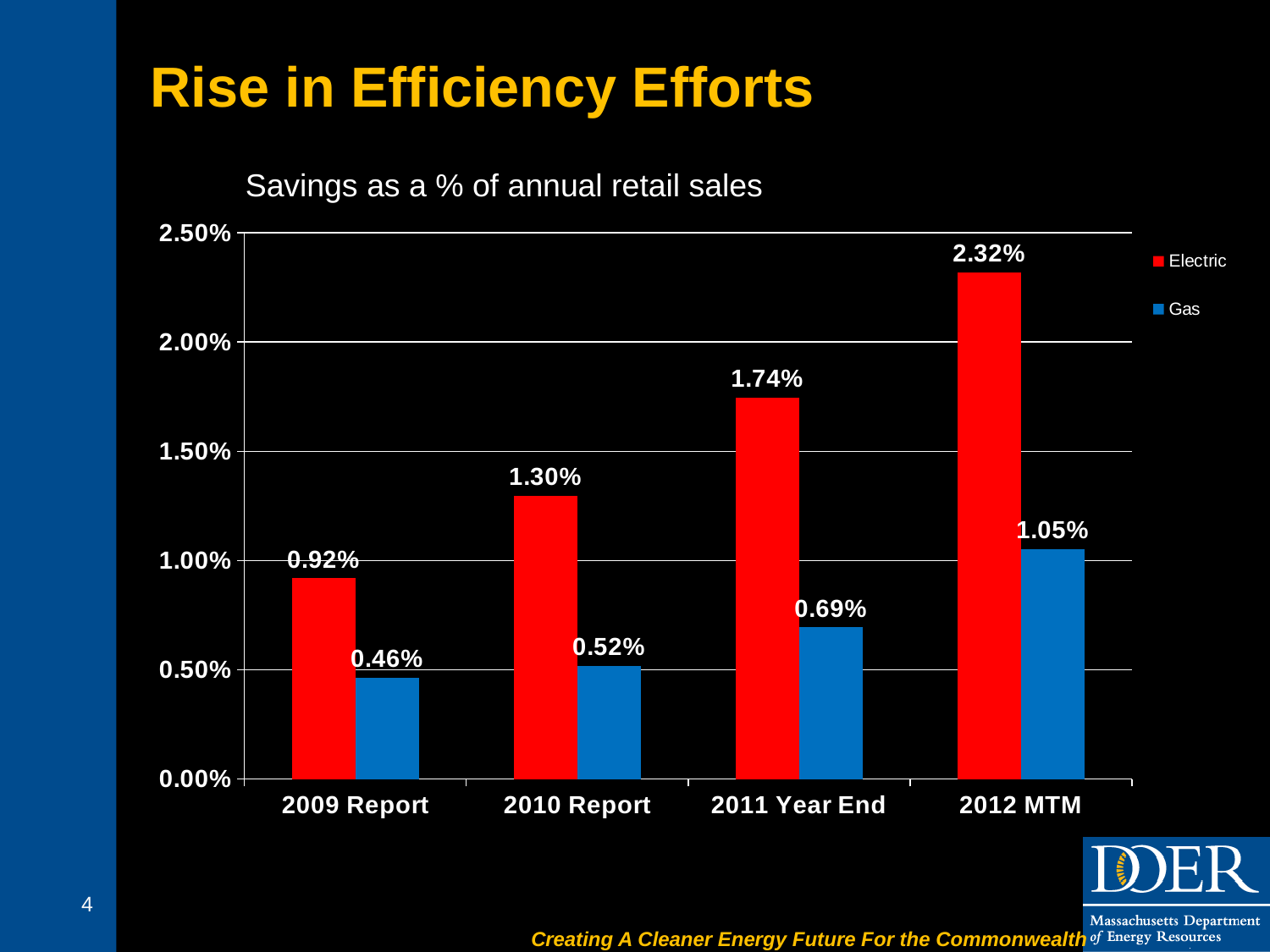
Do the Electric values rise or fall from 2009 Report to 2012 MTM? Rise What is the Gas value for 2010 Report? 0.52% Which category has the highest Gas value? 2012 MTM How many categories are shown on the x axis? 4 Is the Electric value for 2011 Year End greater or less than 1.50%? greater Which is larger, the Electric value for 2010 Report or the Gas value for 2012 MTM? Electric value for 2010 Report How many series does the legend list? 2 What kind of chart is shown on the slide? Bar chart What is the Electric value for 2012 MTM? 2.32% What is the Electric value for 2009 Report? 0.92% What is the difference between the Electric and Gas values for 2011 Year End? 1.05% Which category has the lowest Electric value? 2009 Report